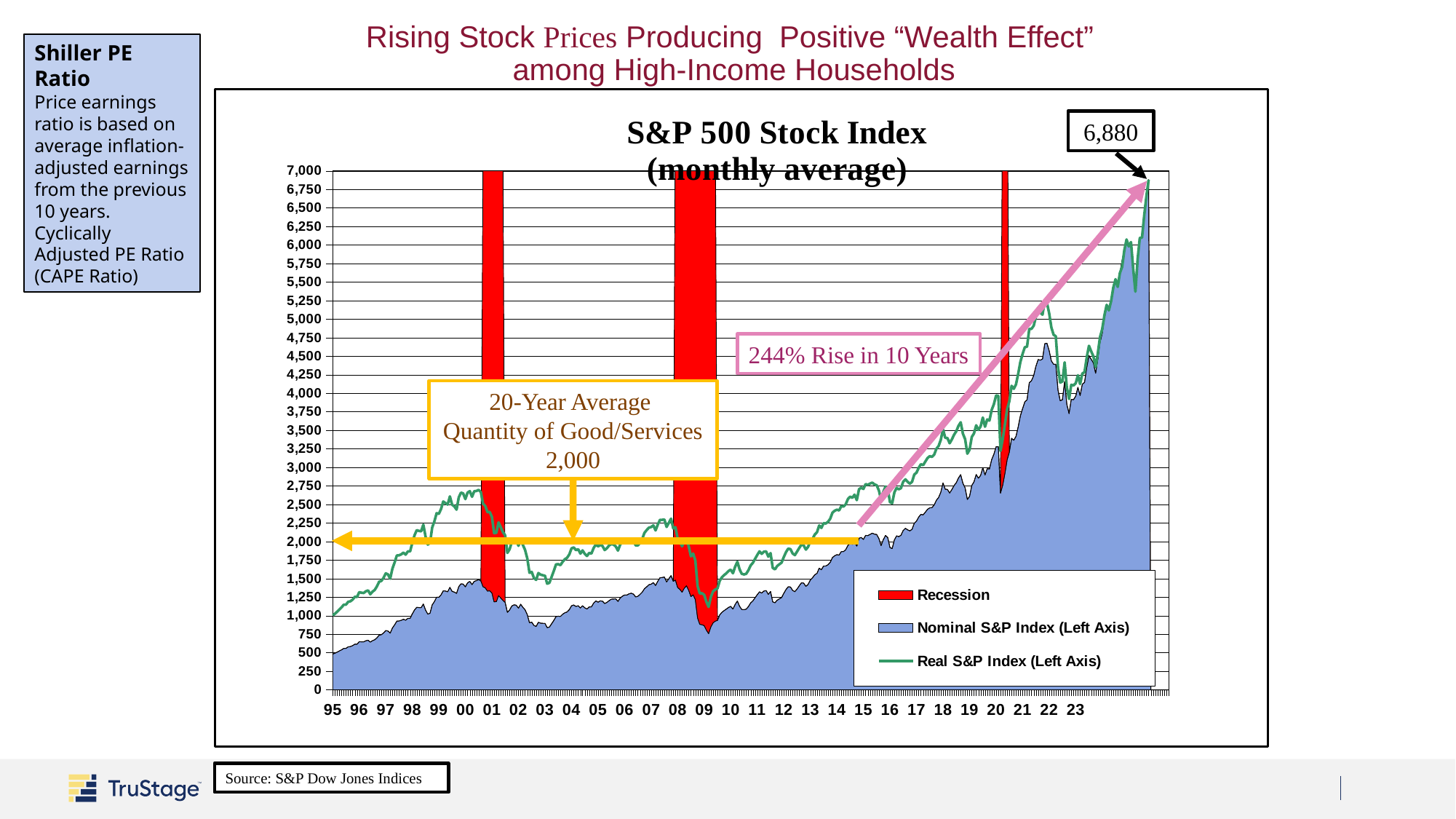
How many entries does the chart's legend list? 3 According to the annotation, by what percentage did the index rise in 10 years? 244% Around the year 2000, which is higher: the Real S&P Index or the Nominal S&P Index? Real S&P Index What colour are the recession bars on the chart? red Is the Nominal S&P Index at its 2000 peak greater or less than 1,000? greater What is the title of the chart on the slide? S&P 500 Stock Index (monthly average) Does the Nominal S&P Index generally rise or fall from 95 to 23? rise What value is given for the 20-Year Average Quantity of Good/Services? 2,000 What value is annotated at the end of the S&P 500 index series? 6,880 Is the Nominal S&P Index at its 2009 low greater or less than 1,000? less Is the Real S&P Index plotted as a line or as bars? line How many recession periods are shaded on the chart? 3